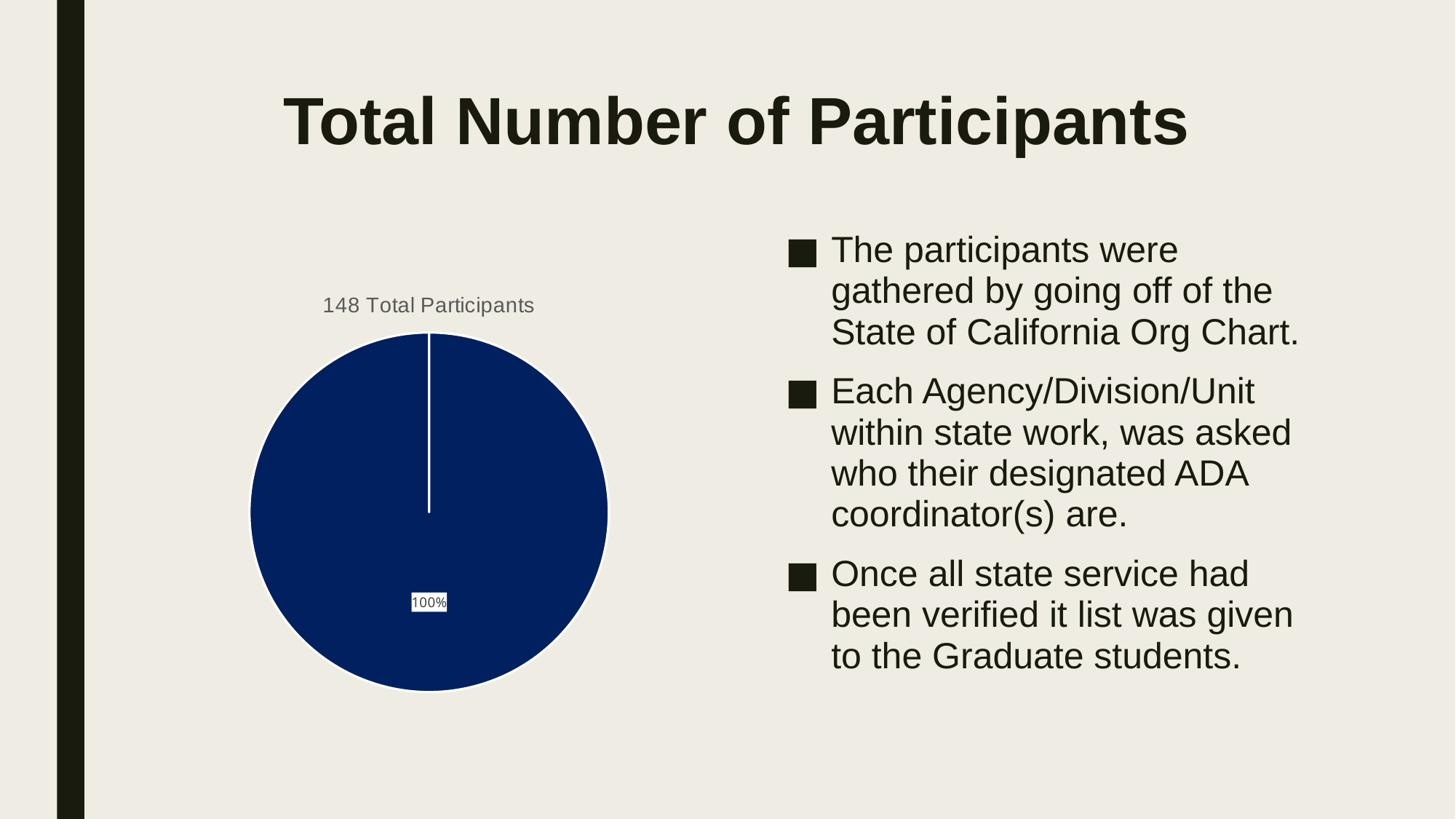
What percentage label is printed on the pie slice? 100% What kind of chart is shown on the slide? pie chart How many total participants does the chart title state? 148 What colour is the pie slice? dark blue What share of the pie does the single slice represent? 100% What is the title of the chart? 148 Total Participants How many slices does the pie chart have? 1